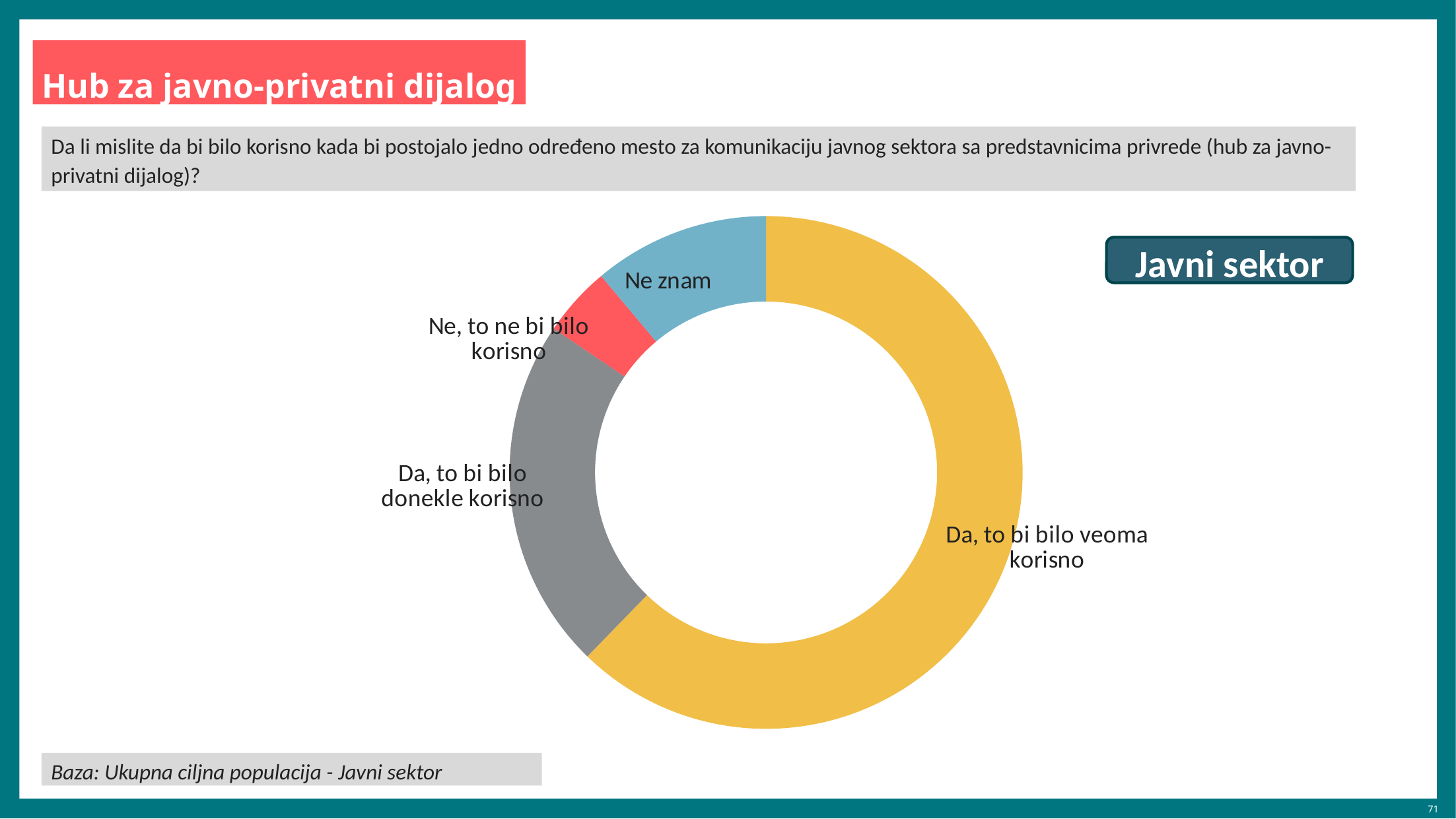
Which category has the largest slice in the chart? Da, to bi bilo veoma korisno What colour is the "Ne znam" slice? Light blue Which slice is larger: "Da, to bi bilo veoma korisno" or "Da, to bi bilo donekle korisno"? Da, to bi bilo veoma korisno What kind of chart is shown on the slide? Pie chart (donut) Which slice is larger: "Da, to bi bilo donekle korisno" or "Ne znam"? Da, to bi bilo donekle korisno Does the "Da, to bi bilo veoma korisno" slice take up more or less than half of the chart? More Which sector does the chart refer to, according to the label on the slide? Javni sektor How many categories (slices) does the chart show? 4 Which category has the smallest slice in the chart? Ne, to ne bi bilo korisno